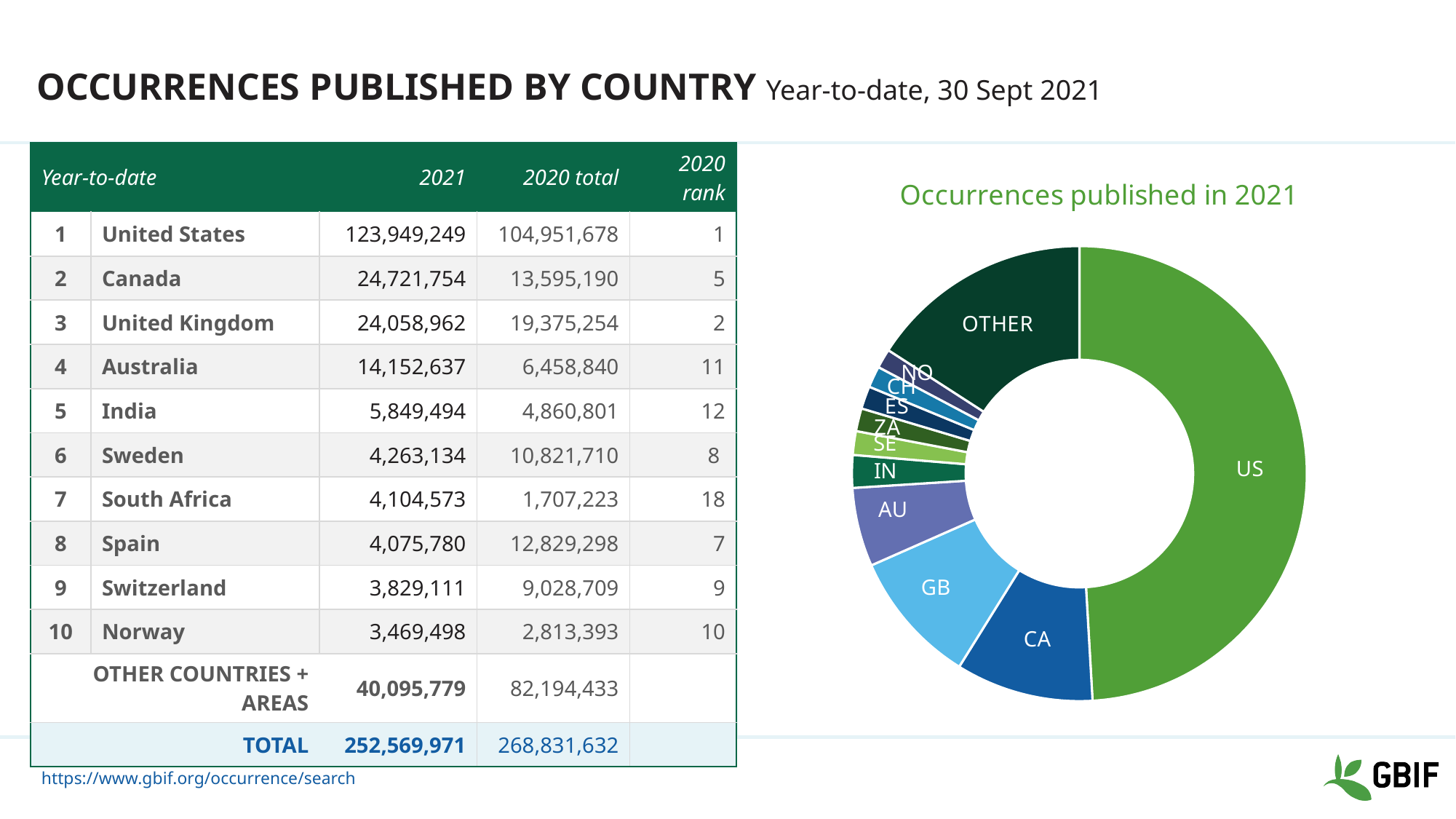
According to the slide, how many occurrences did the United States (US) publish in 2021? 123,949,249 How many slices does the donut chart have? 11 In the donut chart, which slice is larger, OTHER or CA? OTHER What is the title of the chart on the right? Occurrences published in 2021 Which labelled country slice of the donut chart is the smallest? NO What is the total number of occurrences published in 2021 across all slices of the donut chart? 252,569,971 Which slice of the donut chart is the largest? US What kind of chart is shown on the right of the slide? donut (pie) chart What is the 2021 value for the OTHER slice (other countries + areas)? 40,095,779 According to the slide, how many occurrences did Canada (CA) publish in 2021? 24,721,754 What is the difference between the 2021 values for the US and CA slices? 99,227,495 In the donut chart, which slice is larger, AU or IN? AU